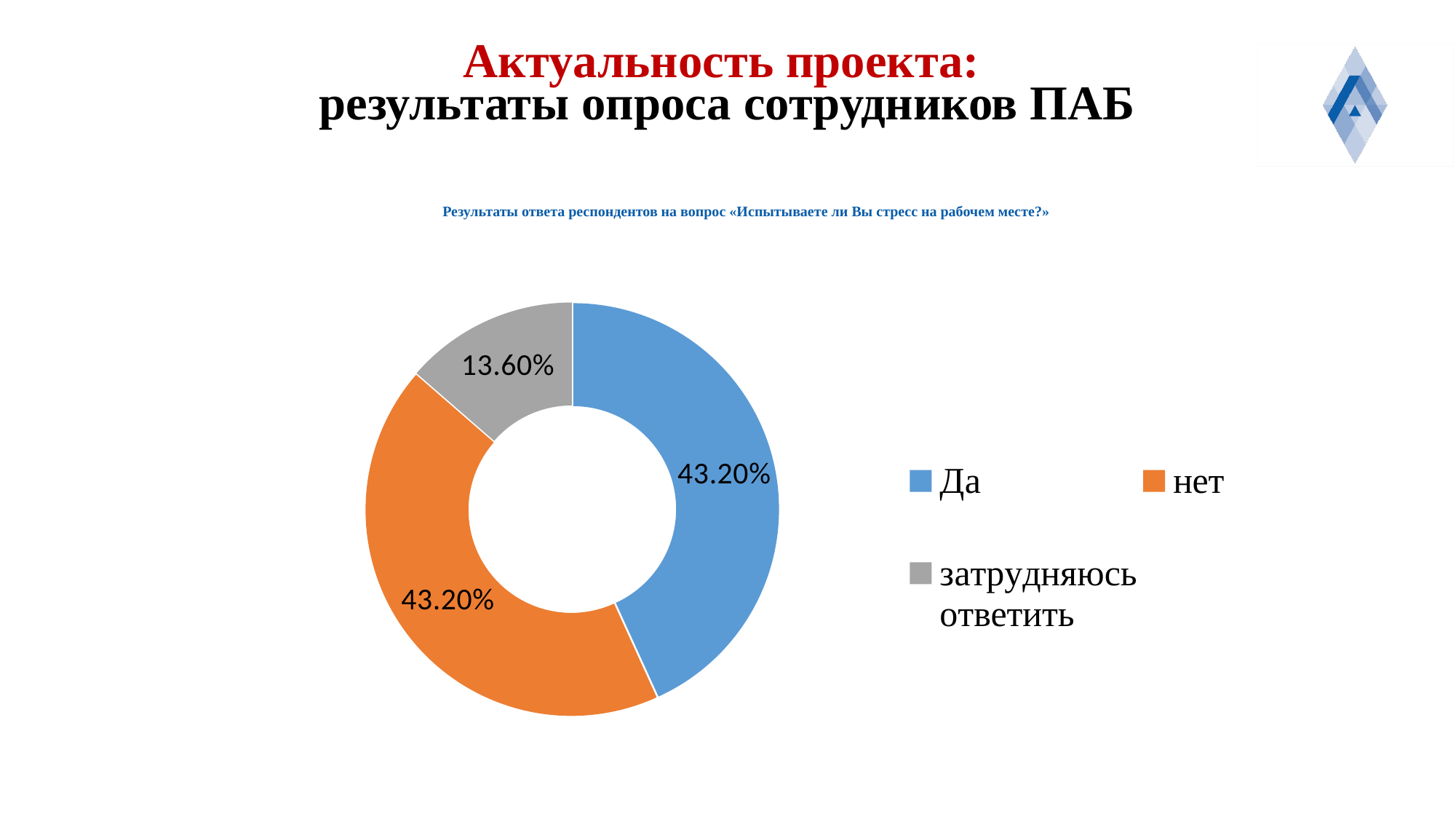
What percentage of respondents answered «нет»? 43.20% What is the difference between the share for «нет» and the share for «затрудняюсь ответить»? 29.60% Which colour represents the «нет» category in the chart? Orange Which is larger: the share for «Да» or the share for «затрудняюсь ответить»? Да What survey question does the chart title say the results refer to? «Испытываете ли Вы стресс на рабочем месте?» What share of the pie is taken by «затрудняюсь ответить»? 13.60% Is the share for «затрудняюсь ответить» greater or less than 20%? less What kind of chart is shown on the slide? Pie (doughnut) chart How many answer categories are shown in the chart? 3 What percentage of respondents answered «Да»? 43.20% Which answer option has the smallest share of respondents? затрудняюсь ответить